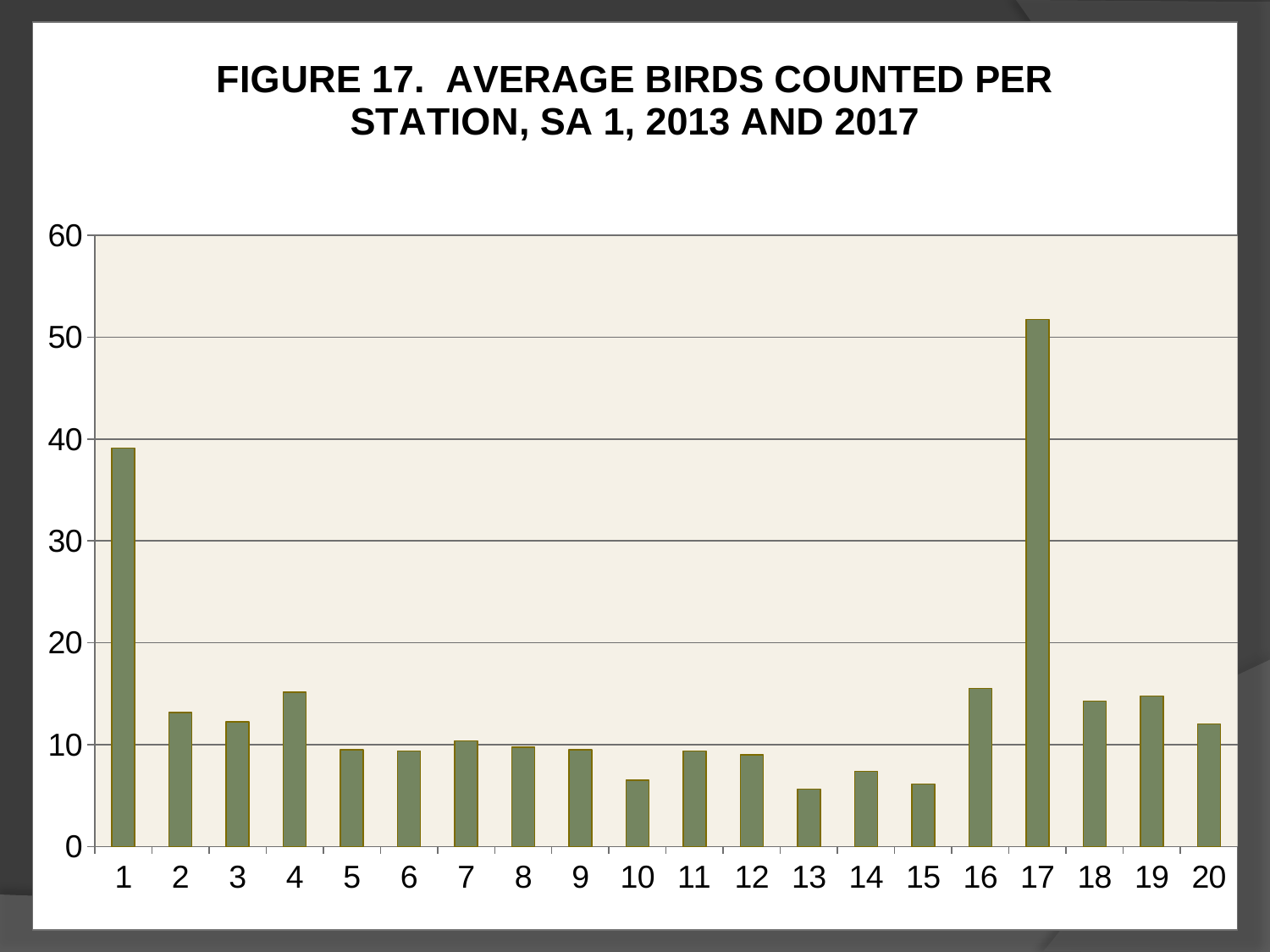
How many stations are plotted along the x axis? 20 Which has a larger value, station 4 or station 5? 4 Is the value for station 1 greater or less than 30? greater Which has a larger value, station 1 or station 17? 17 Is the value for station 13 greater or less than 10? less What kind of chart is shown on the slide? bar chart Is the value for station 4 greater or less than 10? greater Which has a larger value, station 2 or station 14? 2 Which station has the highest average birds counted? 17 What is the title of the chart? FIGURE 17. AVERAGE BIRDS COUNTED PER STATION, SA 1, 2013 AND 2017